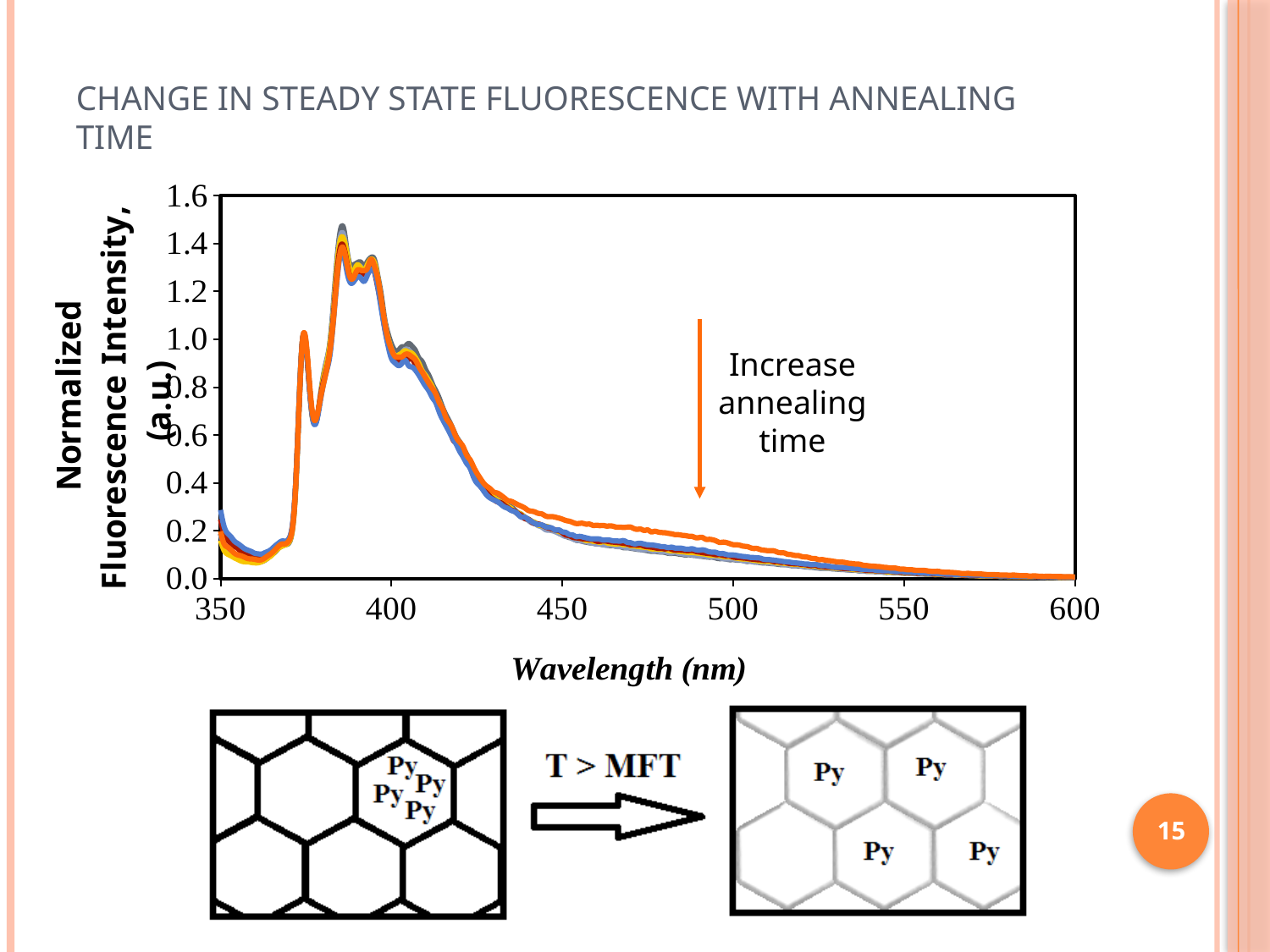
Is the normalized fluorescence intensity at 360 nm greater or less than 0.4? less Which of the two is larger: the intensity at 400 nm or the intensity at 500 nm? 400 nm What is the highest value shown on the y axis of the chart? 1.6 Is the normalized fluorescence intensity at 550 nm greater or less than 0.2? less Which of the two is larger: the intensity at 375 nm or the intensity at 450 nm? 375 nm What is the label of the x axis of the chart? Wavelength (nm) What is the label of the y axis of the chart? Normalized Fluorescence Intensity, (a.u.) How many tick labels are shown on the x axis of the chart? 6 Is the normalized fluorescence intensity at the highest peak (near 385 nm) greater or less than 1.2? greater Do the curves rise or fall as wavelength increases from 450 nm to 600 nm? fall What kind of chart is shown on the slide? line chart